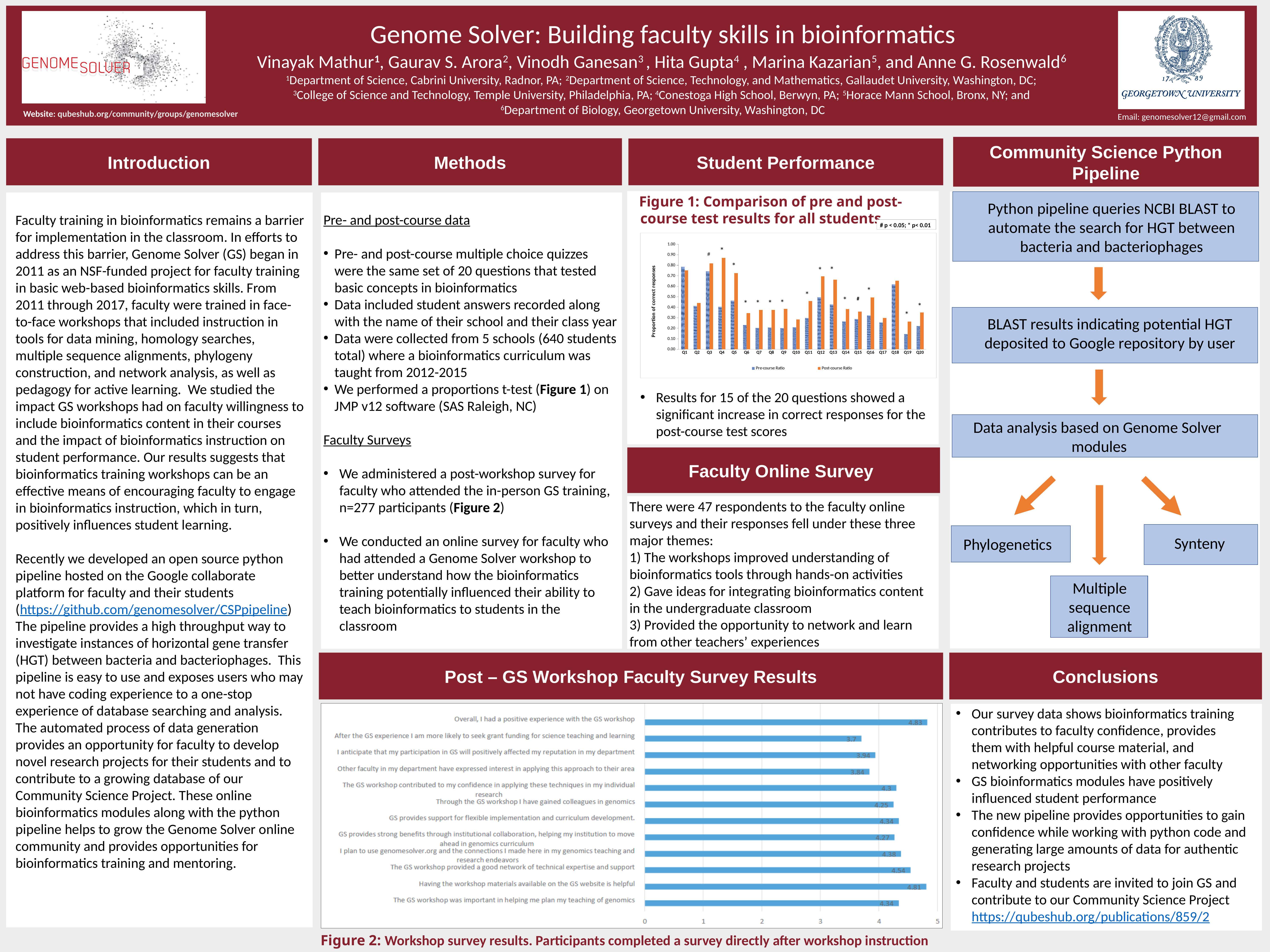
How many series does the legend of Figure 1 list? 2 In the Post – GS Workshop Faculty Survey Results chart, what is the difference between the values for "Having the workshop materials available on the GS website is helpful" and "Other faculty in my department have expressed interest in applying this approach to their area"? 0.97 In Figure 1, is the Post-course Ratio for Q4 greater or less than 0.80? greater In the Post – GS Workshop Faculty Survey Results chart, what is the value for "Overall, I had a positive experience with the GS workshop"? 4.83 In the Post – GS Workshop Faculty Survey Results chart, which statement has the lowest value? After the GS experience I am more likely to seek grant funding for science teaching and learning In Figure 1, is the Pre-course Ratio for Q6 greater or less than 0.30? less In the Post – GS Workshop Faculty Survey Results chart, which statement has the highest value? Overall, I had a positive experience with the GS workshop How many questions are shown on the x axis of Figure 1? 20 In the Post – GS Workshop Faculty Survey Results chart, what is the value for "The GS workshop provided a good network of technical expertise and support"? 4.54 In the Post – GS Workshop Faculty Survey Results chart, which is larger: the value for "I plan to use genomesolver.org and the connections I made here in my genomics teaching and research endeavors" or the value for "Through the GS workshop I have gained colleagues in genomics"? I plan to use genomesolver.org and the connections I made here in my genomics teaching and research endeavors How many statements are plotted in the Post – GS Workshop Faculty Survey Results chart? 12 What kind of chart is the Post – GS Workshop Faculty Survey Results chart? Bar chart